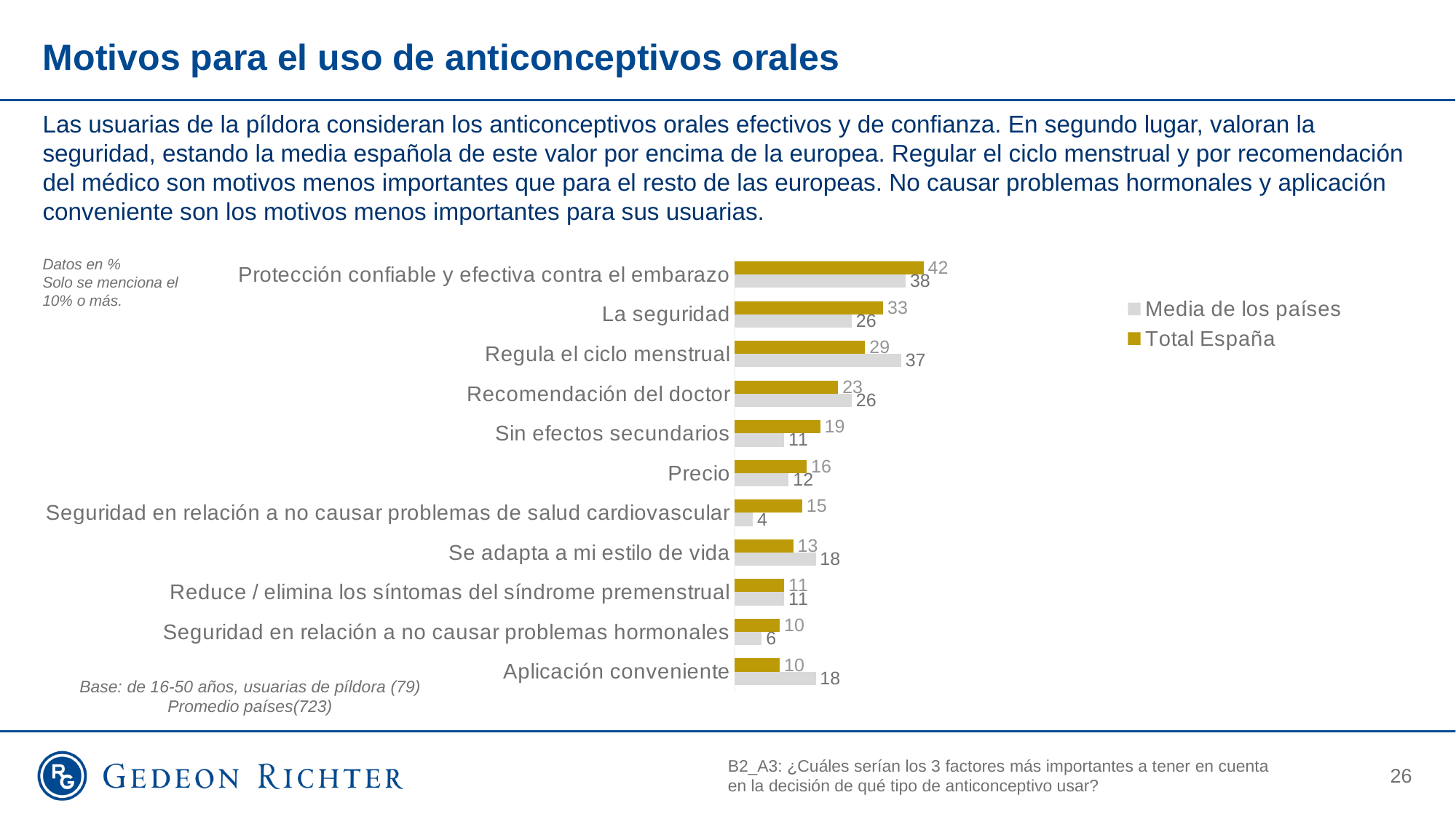
How many categories are shown in the chart? 11 For 'Aplicación conveniente', which is larger: Total España or Media de los países? Media de los países Which colour represents the Total España series in the chart? Gold What kind of chart is shown on the slide? Bar chart What is the Media de los países value for 'Seguridad en relación a no causar problemas de salud cardiovascular'? 4 What is the Total España value for 'Protección confiable y efectiva contra el embarazo'? 42 What is the Media de los países value for 'Regula el ciclo menstrual'? 37 For 'Sin efectos secundarios', which is larger: Total España or Media de los países? Total España Which category has the lowest Media de los países value? Seguridad en relación a no causar problemas de salud cardiovascular How many series does the legend list? 2 What is the difference between the Total España and Media de los países values for 'La seguridad'? 7 Which category has the highest Total España value? Protección confiable y efectiva contra el embarazo